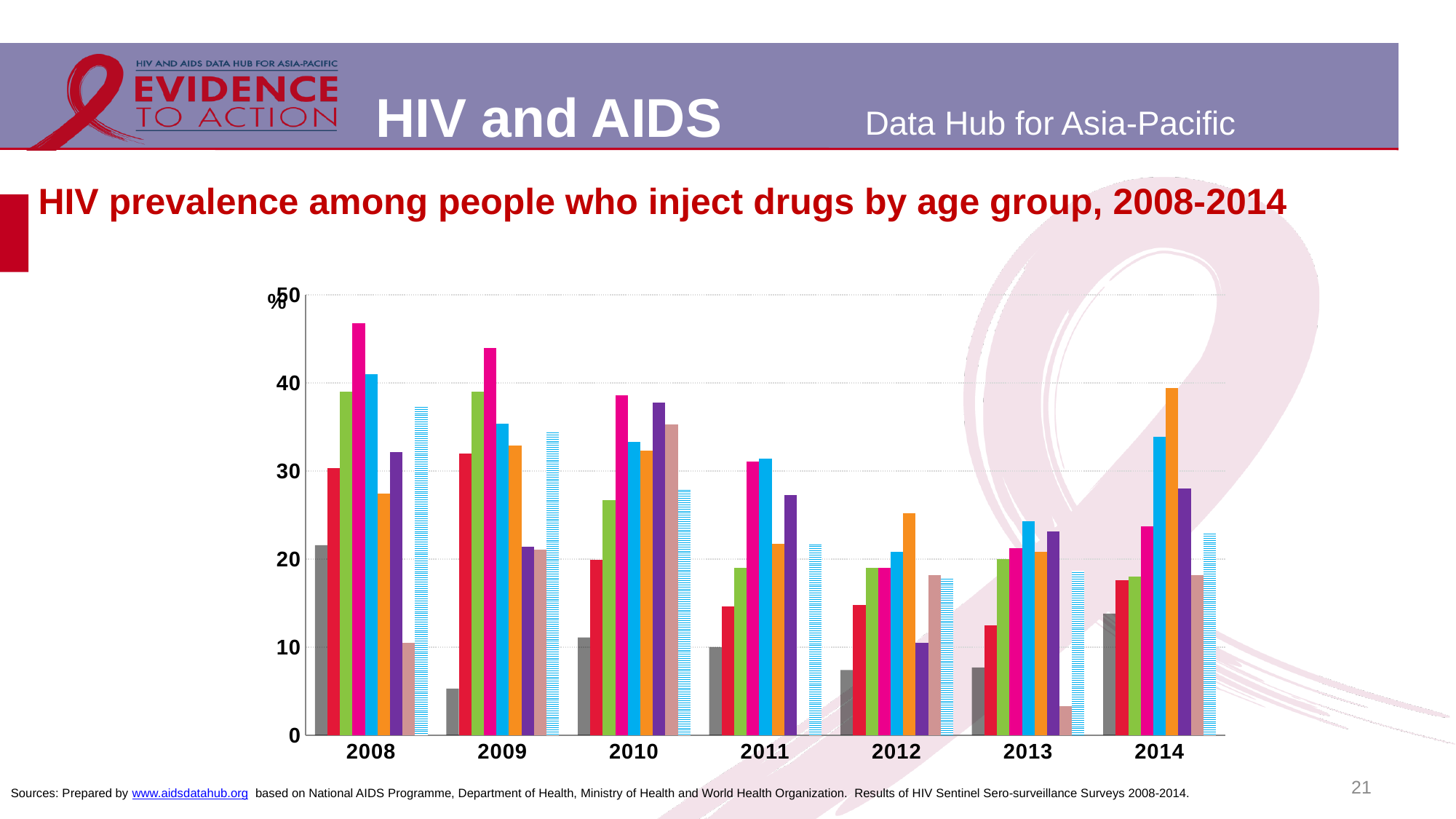
Is the tallest bar in the 2008 group greater or less than 40? greater Is the shortest bar in the 2009 group greater or less than 10? less How many bars are plotted for each year in the chart? 9 (except 2011, which has 8) Is the tallest bar in the 2012 group greater or less than 30? less How many years (categories) are shown along the x axis of the chart? 7 Which year contains the single tallest bar in the chart? 2008 From 2008 to 2012, does the height of the tallest bar in each year group generally rise or fall? fall What is the title of the chart on the slide? HIV prevalence among people who inject drugs by age group, 2008-2014 What is the highest value marked on the y axis of the chart? 50 What kind of chart is shown on the slide? bar chart What unit is shown on the y axis of the chart? %